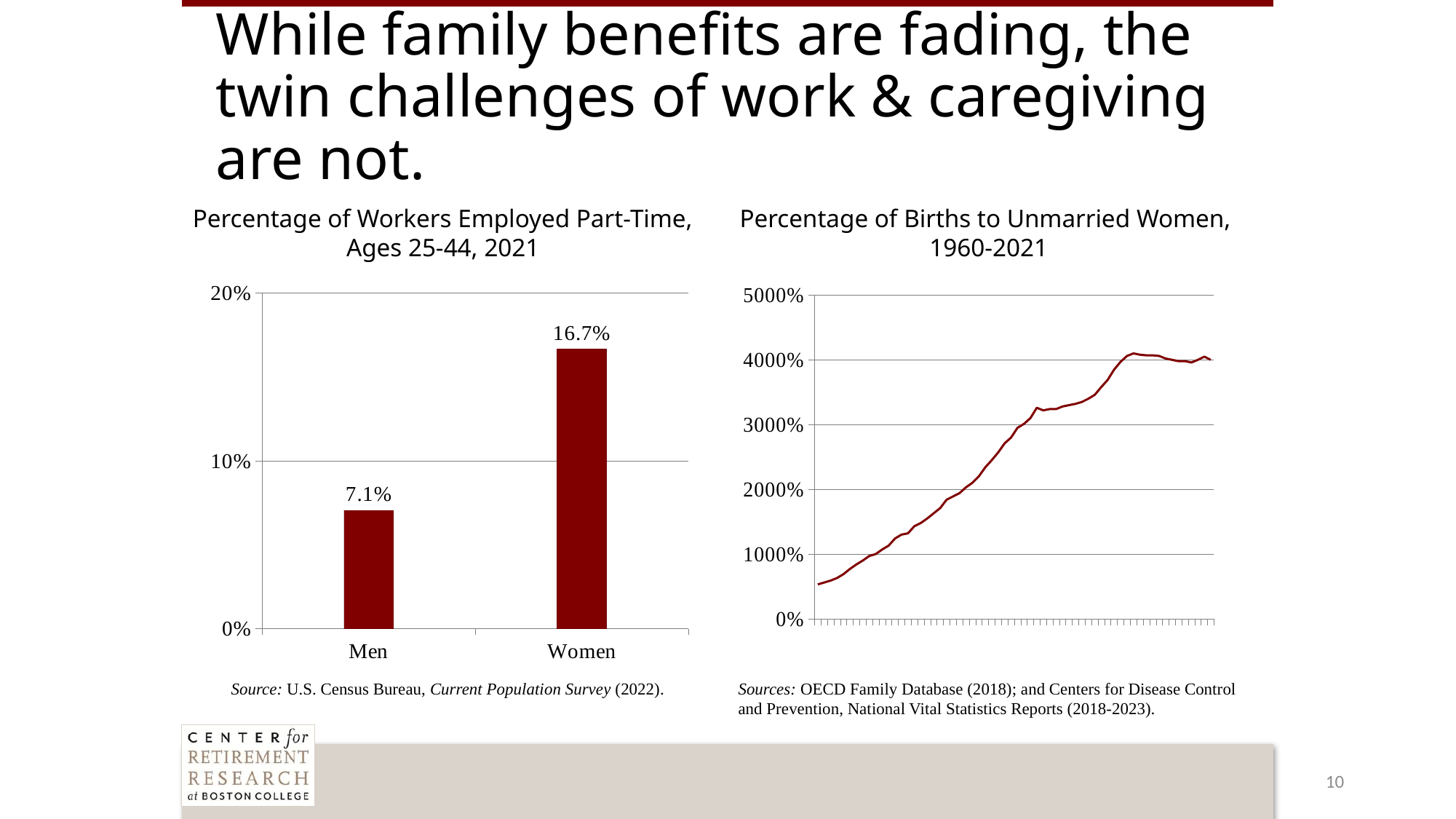
In the left chart on part-time workers, is the value for Men larger or smaller than the value for Women? smaller In the chart titled "Percentage of Workers Employed Part-Time, Ages 25-44, 2021", what is the value for Men? 7.1% In the left chart on part-time workers, what is the difference between the values for Women and Men? 9.6% In the left chart on part-time workers, which category has the highest value? Women In the chart titled "Percentage of Workers Employed Part-Time, Ages 25-44, 2021", what is the value for Women? 16.7% How many categories are shown in the left chart on part-time workers? 2 What kind of chart is the left chart on part-time workers? bar chart In the left chart on part-time workers, which category has the lowest value? Men In the right chart on births to unmarried women, do the values generally rise or fall from left to right? rise In the left chart on part-time workers, is the value for Women greater or less than 10%? greater What kind of chart is the right chart titled "Percentage of Births to Unmarried Women, 1960-2021"? line chart In the right chart on births to unmarried women, is the highest point of the line greater or less than 3000%? greater